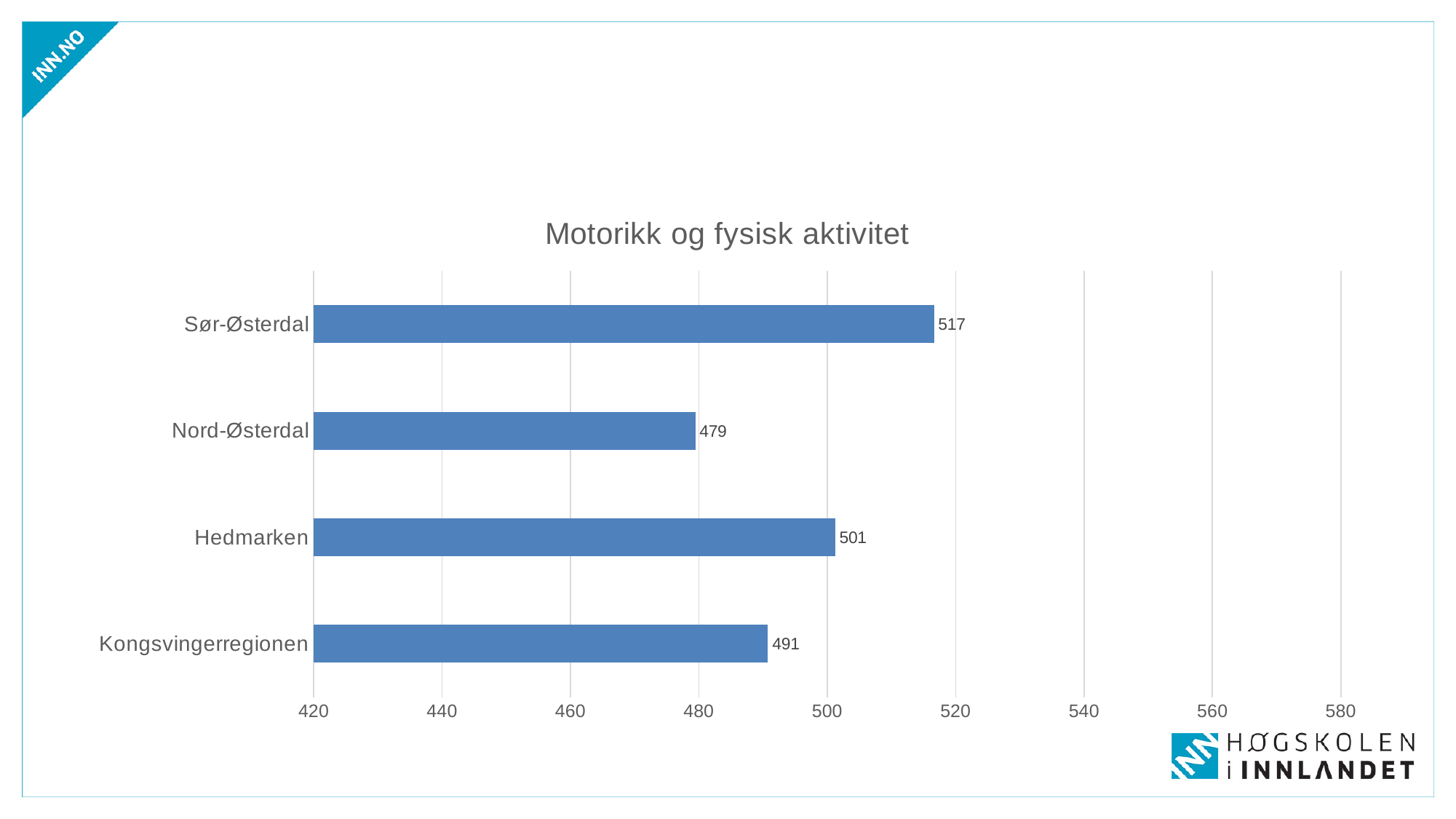
How many regions are shown in the chart? 4 What is the value for Sør-Østerdal? 517 What is the value for Nord-Østerdal? 479 Which is larger, the value for Hedmarken or the value for Kongsvingerregionen? Hedmarken Which region has the highest value? Sør-Østerdal What is the value for Kongsvingerregionen? 491 What is the value for Hedmarken? 501 What type of chart is shown on the slide? bar chart Which region has the lowest value? Nord-Østerdal What is the difference between the values for Hedmarken and Kongsvingerregionen? 10 What is the difference between the values for Sør-Østerdal and Nord-Østerdal? 38 Is the value for Nord-Østerdal greater or less than 480? less